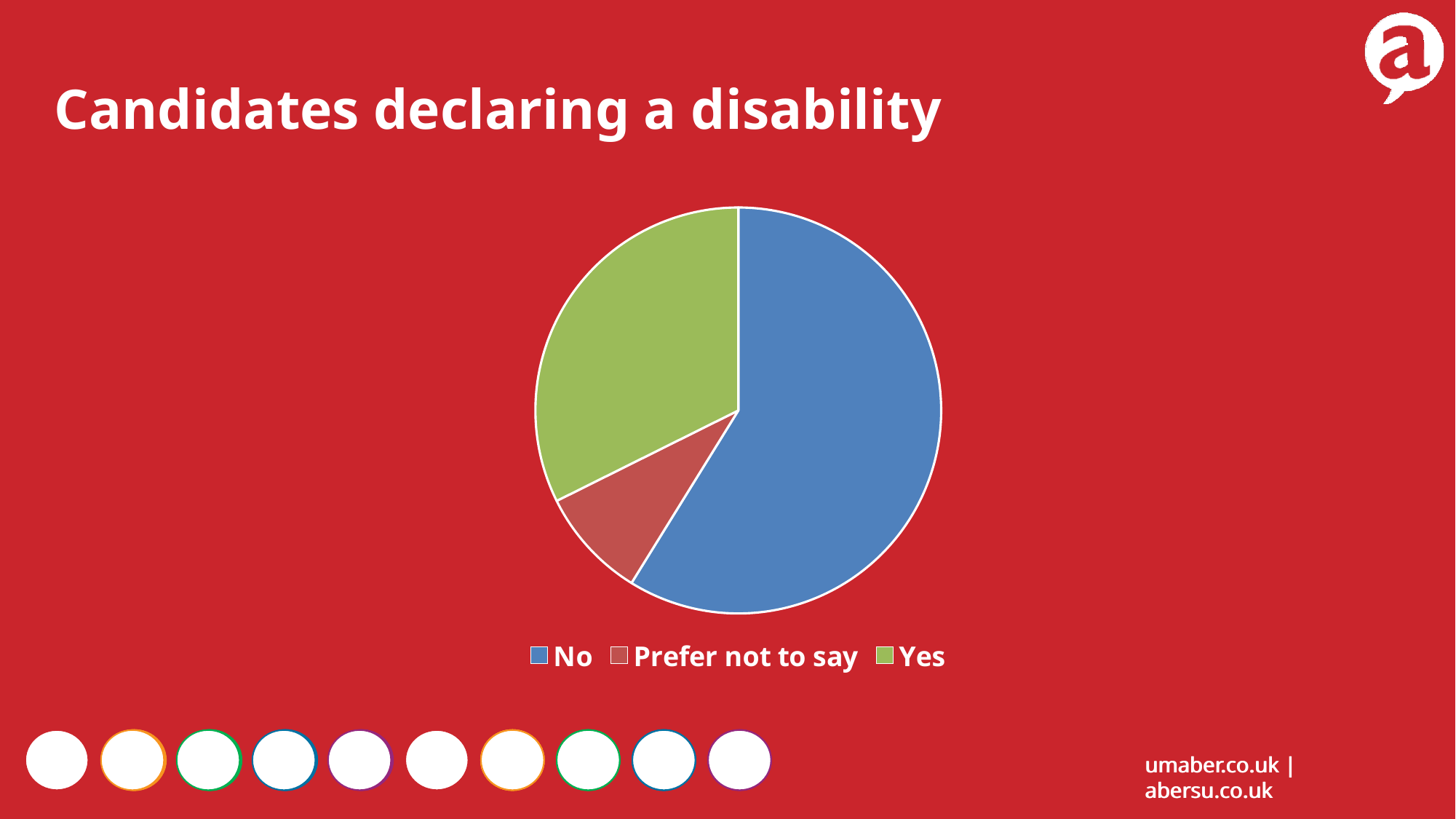
Which category has the smallest slice of the pie? Prefer not to say Which slice is smaller, No or Prefer not to say? Prefer not to say How many categories does the pie chart show? 3 What kind of chart is shown on the slide? Pie chart What colour is the slice for Yes? Green Which slice is larger, Yes or Prefer not to say? Yes Which slice is larger, No or Yes? No Which category has the largest slice of the pie? No How many entries does the legend list? 3 What is the title of the chart? Candidates declaring a disability